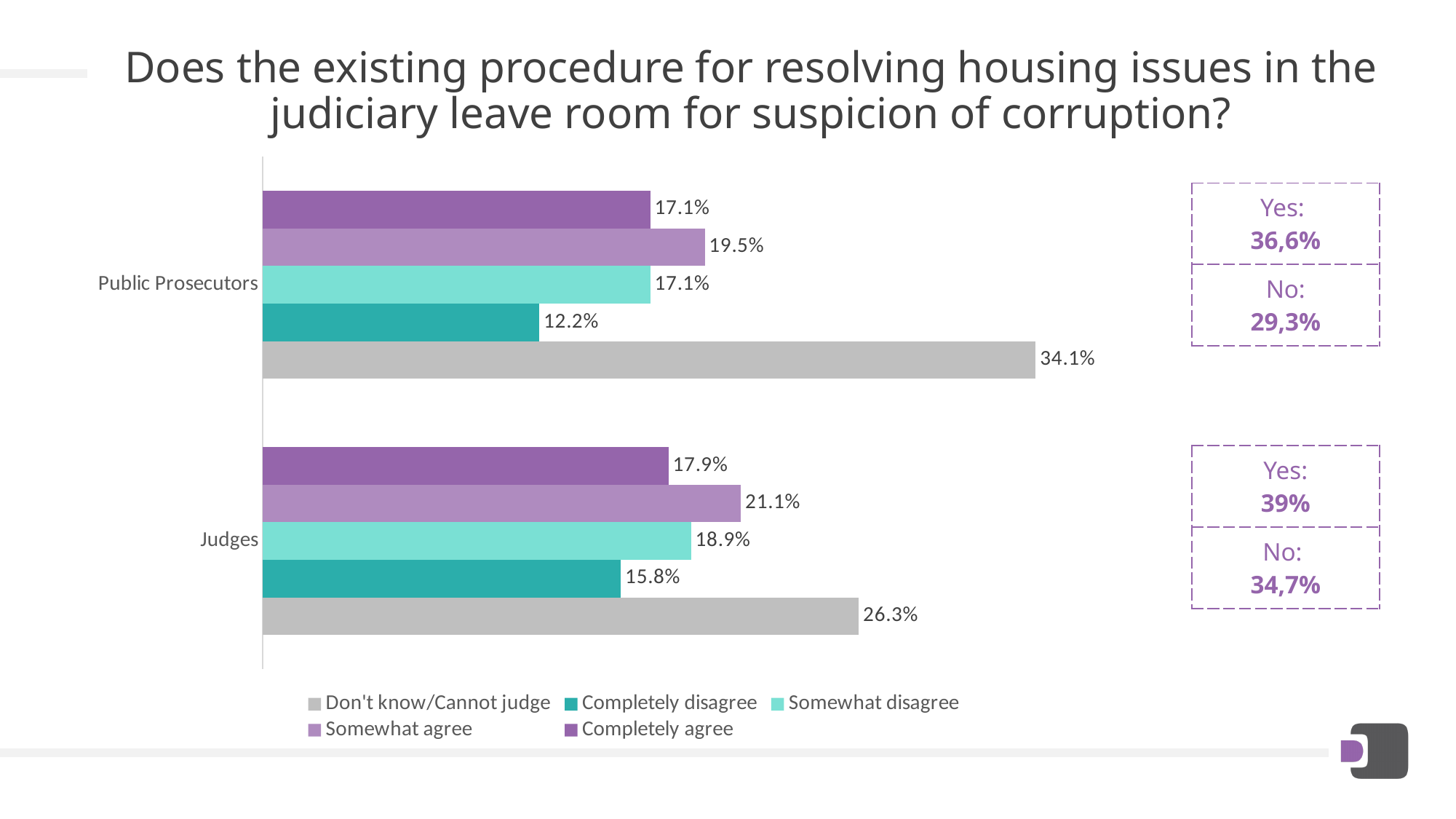
What is the difference between "Don't know/Cannot judge" for Public Prosecutors and for Judges? 7.8% What colour are the "Don't know/Cannot judge" bars? Grey What kind of chart is shown on the slide? Bar chart What is the value for "Don't know/Cannot judge" among Public Prosecutors? 34.1% What is the value for "Completely disagree" among Judges? 15.8% What is the value for "Somewhat agree" among Public Prosecutors? 19.5% How many groups of respondents are shown on the chart? 2 What is the value for "Completely agree" among Judges? 17.9% Which response category has the lowest value among Public Prosecutors? Completely disagree How many series does the legend list? 5 Which is larger: "Somewhat disagree" for Judges or "Somewhat disagree" for Public Prosecutors? Judges Which response category has the highest value among Judges? Don't know/Cannot judge